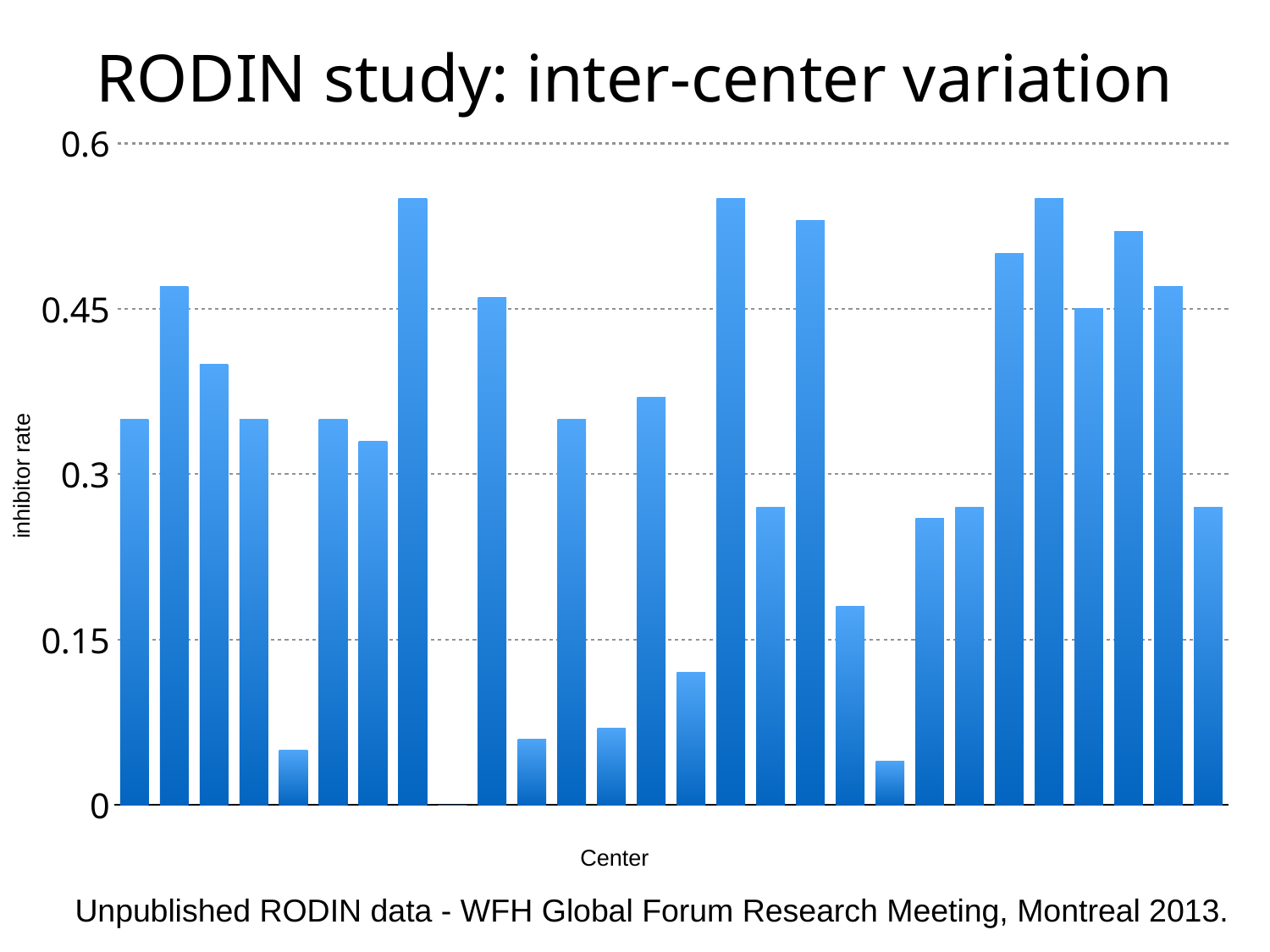
Is the value for the fifth bar from the left greater or less than 0.15? less Is the value for the last (rightmost) bar greater or less than 0.3? less Is the value for the first (leftmost) bar greater or less than 0.3? greater What is the label on the vertical axis of the chart? inhibitor rate How many data series are plotted in the chart? 1 What is the title of the chart? RODIN study: inter-center variation Which is larger, the value for the first bar or the value for the second bar? the second bar What kind of chart is shown on the slide? bar chart